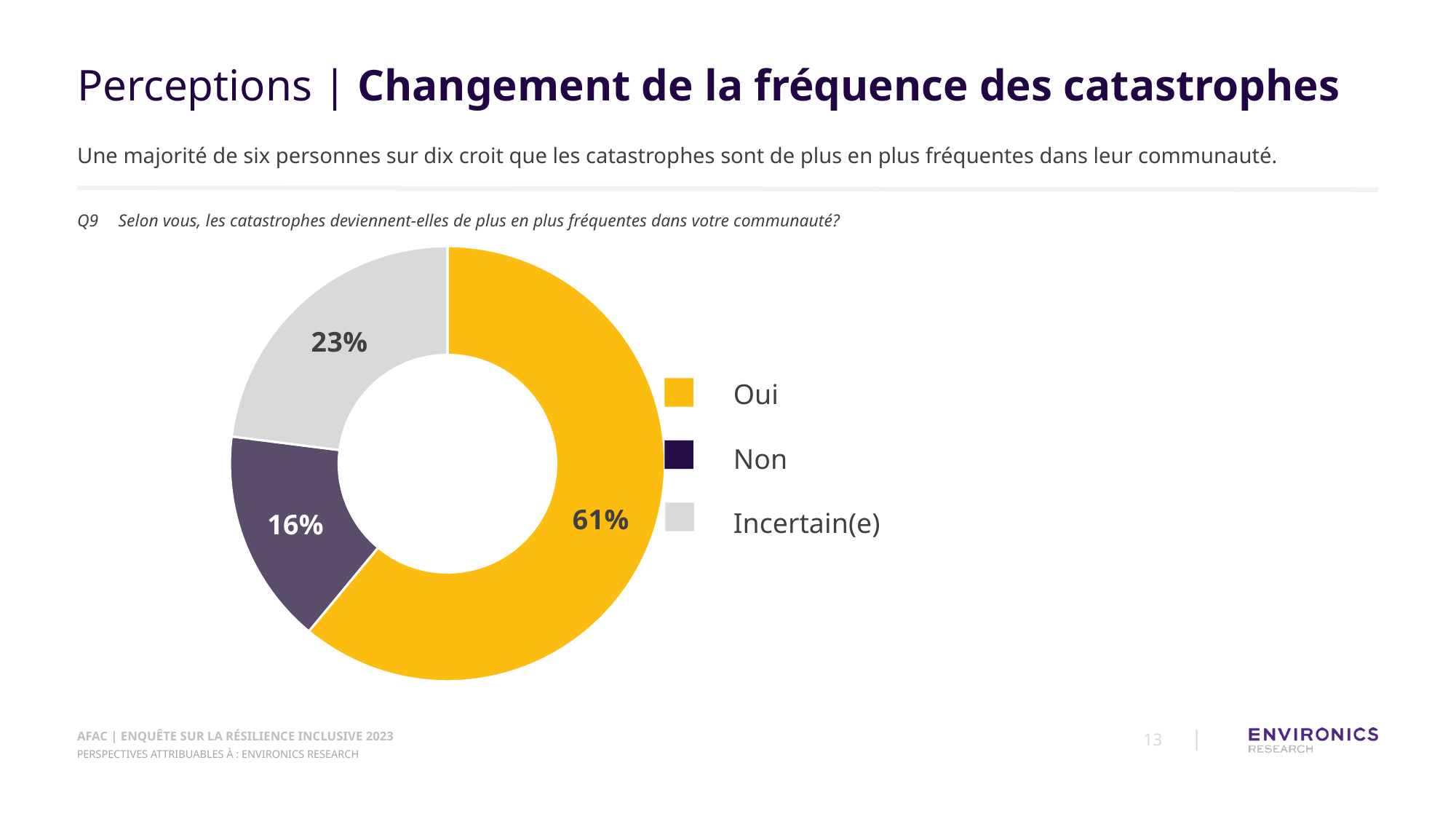
What is the difference in percentage points between "Oui" and "Non"? 45 What percentage of respondents answered "Incertain(e)"? 23% Which is larger, the share for "Incertain(e)" or the share for "Non"? Incertain(e) How many categories does the chart show? 3 What is the difference in percentage points between "Incertain(e)" and "Non"? 7 Which response has the largest share of the chart? Oui What percentage of respondents answered "Oui"? 61% What kind of chart is shown on the slide? Doughnut chart What colour represents "Oui" in the chart? Yellow Which response has the smallest share of the chart? Non What percentage of respondents answered "Non"? 16% What colour represents "Incertain(e)" in the chart? Grey